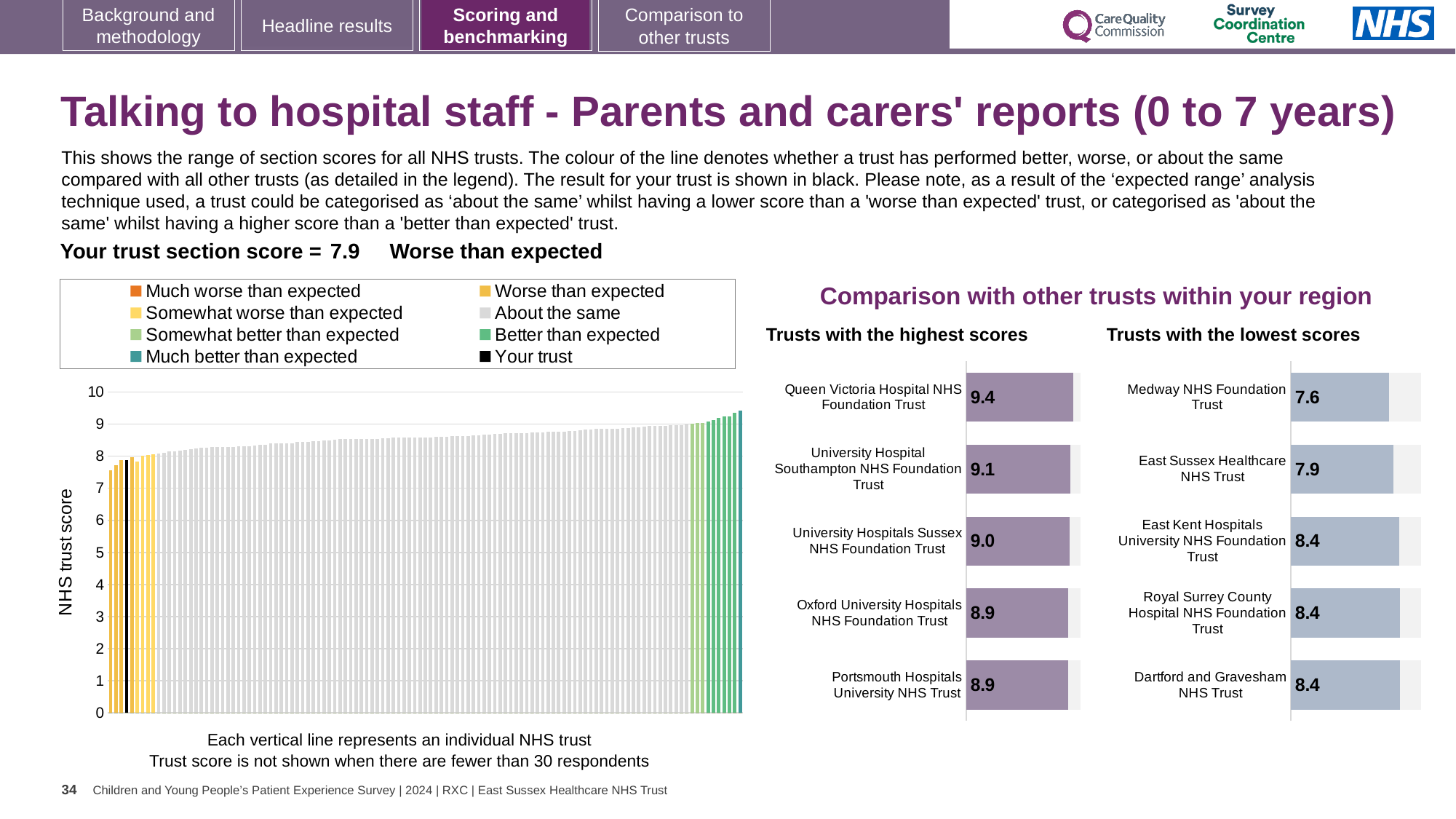
What is the label on the vertical axis of the large chart on the left? NHS trust score In the 'Trusts with the highest scores' chart, what is the difference between the scores of Queen Victoria Hospital NHS Foundation Trust and Portsmouth Hospitals University NHS Trust? 0.5 How many entries does the legend above the large chart on the left list? 8 In the 'Trusts with the highest scores' chart, which trust has the highest score? Queen Victoria Hospital NHS Foundation Trust In the 'Trusts with the lowest scores' chart, which trust has the lowest score? Medway NHS Foundation Trust How many trusts are shown in the 'Trusts with the highest scores' chart? 5 In the large chart on the left, is the value of the tallest bar greater or less than 9? greater In the 'Trusts with the lowest scores' chart, which has the higher score: East Sussex Healthcare NHS Trust or East Kent Hospitals University NHS Foundation Trust? East Kent Hospitals University NHS Foundation Trust In the large chart on the left, do the NHS trust scores rise or fall from left to right? Rise In the 'Trusts with the highest scores' chart, what is the score for Queen Victoria Hospital NHS Foundation Trust? 9.4 In the 'Trusts with the lowest scores' chart, what is the score for Medway NHS Foundation Trust? 7.6 What kind of chart is the large chart on the left showing NHS trust scores? Bar chart